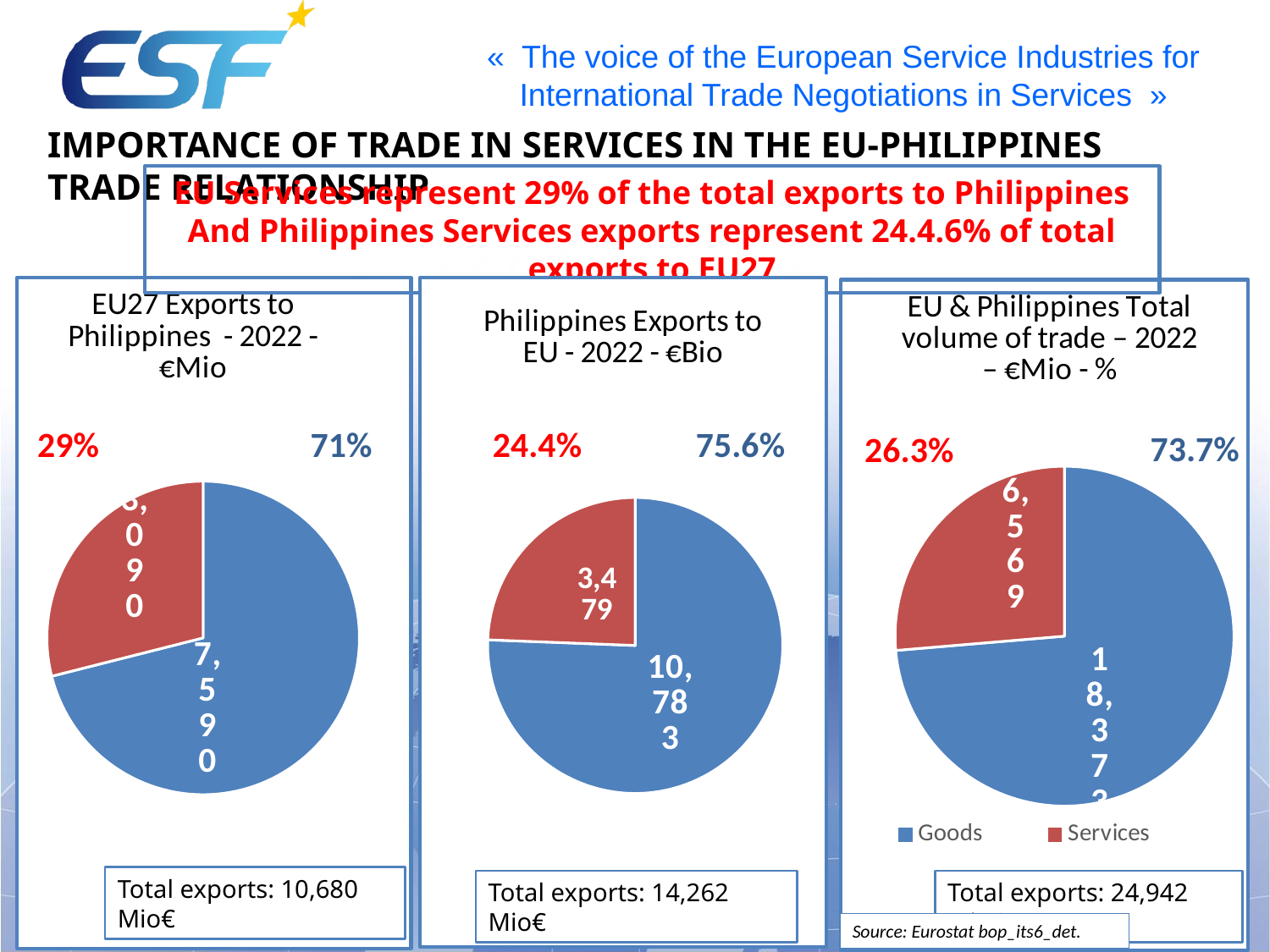
In the 'EU27 Exports to Philippines - 2022 - €Mio' chart, what share does the red slice represent? 29% In the 'EU27 Exports to Philippines - 2022 - €Mio' chart, what total exports figure is shown? 10,680 Mio€ In the 'Philippines Exports to EU - 2022 - €Bio' chart, what share does the red slice represent? 24.4 How many series does the legend of the 'EU & Philippines Total volume of trade – 2022' chart list? 2 What kind of charts are shown on the slide? Pie charts In the 'EU27 Exports to Philippines - 2022 - €Mio' chart, what value is labelled on the blue slice? 7,590 In the 'EU & Philippines Total volume of trade – 2022' chart, what value is labelled on the Services slice? 6,569 In the 'EU27 Exports to Philippines - 2022 - €Mio' chart, what share does the blue slice represent? 71% In the 'Philippines Exports to EU - 2022 - €Bio' chart, what value is labelled on the blue slice? 10,783 In the 'Philippines Exports to EU - 2022 - €Bio' chart, what is the difference between the blue slice value and the red slice value? 7,304 In the 'Philippines Exports to EU - 2022 - €Bio' chart, what value is labelled on the red slice? 3,479